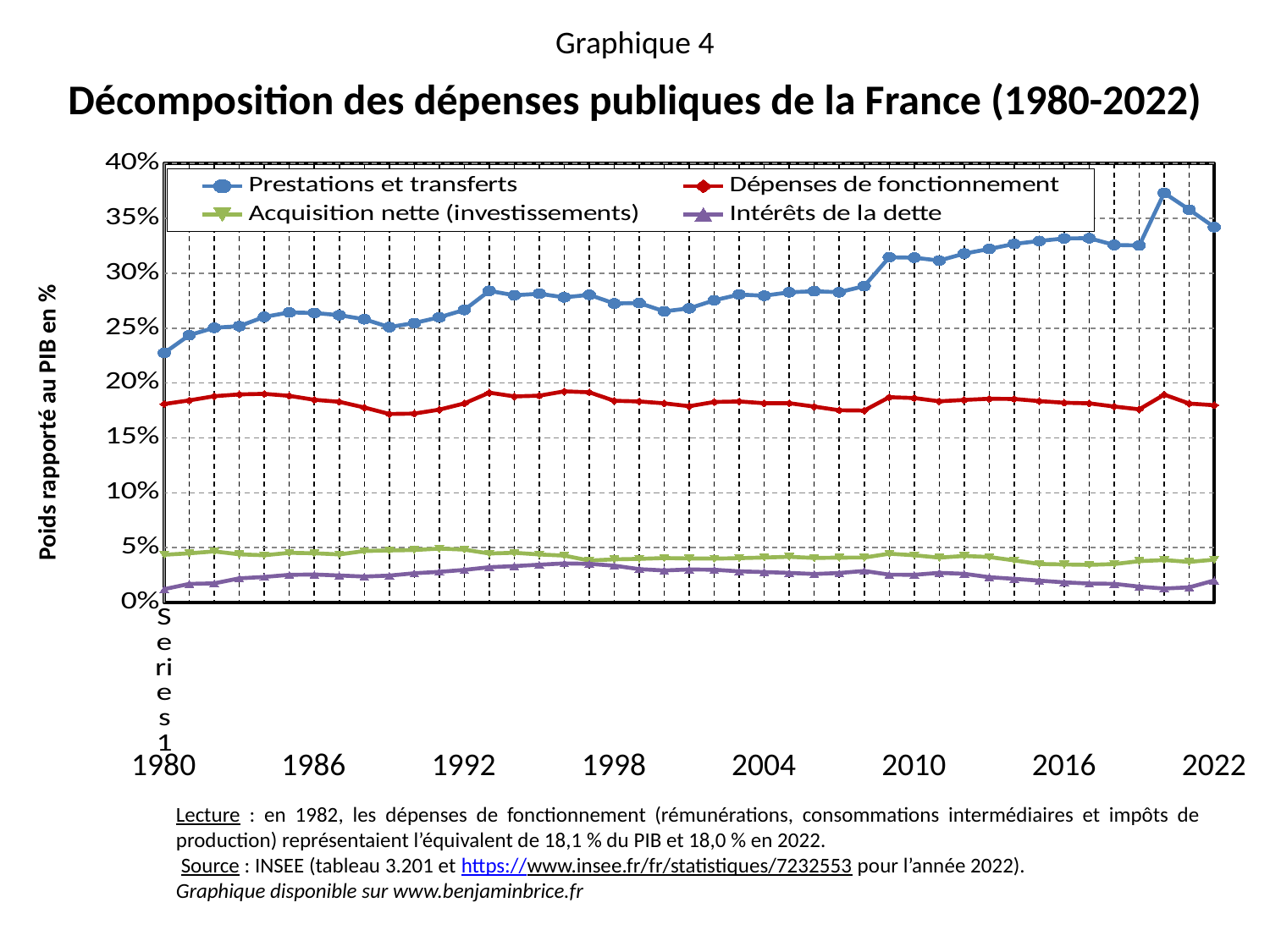
Does the Prestations et transferts series rise or fall overall from 1980 to 2022? rise What is the title of the chart? Décomposition des dépenses publiques de la France (1980-2022) Which series has the lowest value in 2022? Intérêts de la dette Is the value for Intérêts de la dette in 1980 greater or less than 5%? less Is the value for Prestations et transferts in 1980 greater or less than 25%? less Is the value for Dépenses de fonctionnement in 2010 greater or less than 20%? less What is the label of the vertical axis? Poids rapporté au PIB en % What kind of chart is shown on the slide? line chart In 2022, which is larger: Prestations et transferts or Dépenses de fonctionnement? Prestations et transferts How many series does the legend list? 4 Which series has the highest values throughout the period? Prestations et transferts